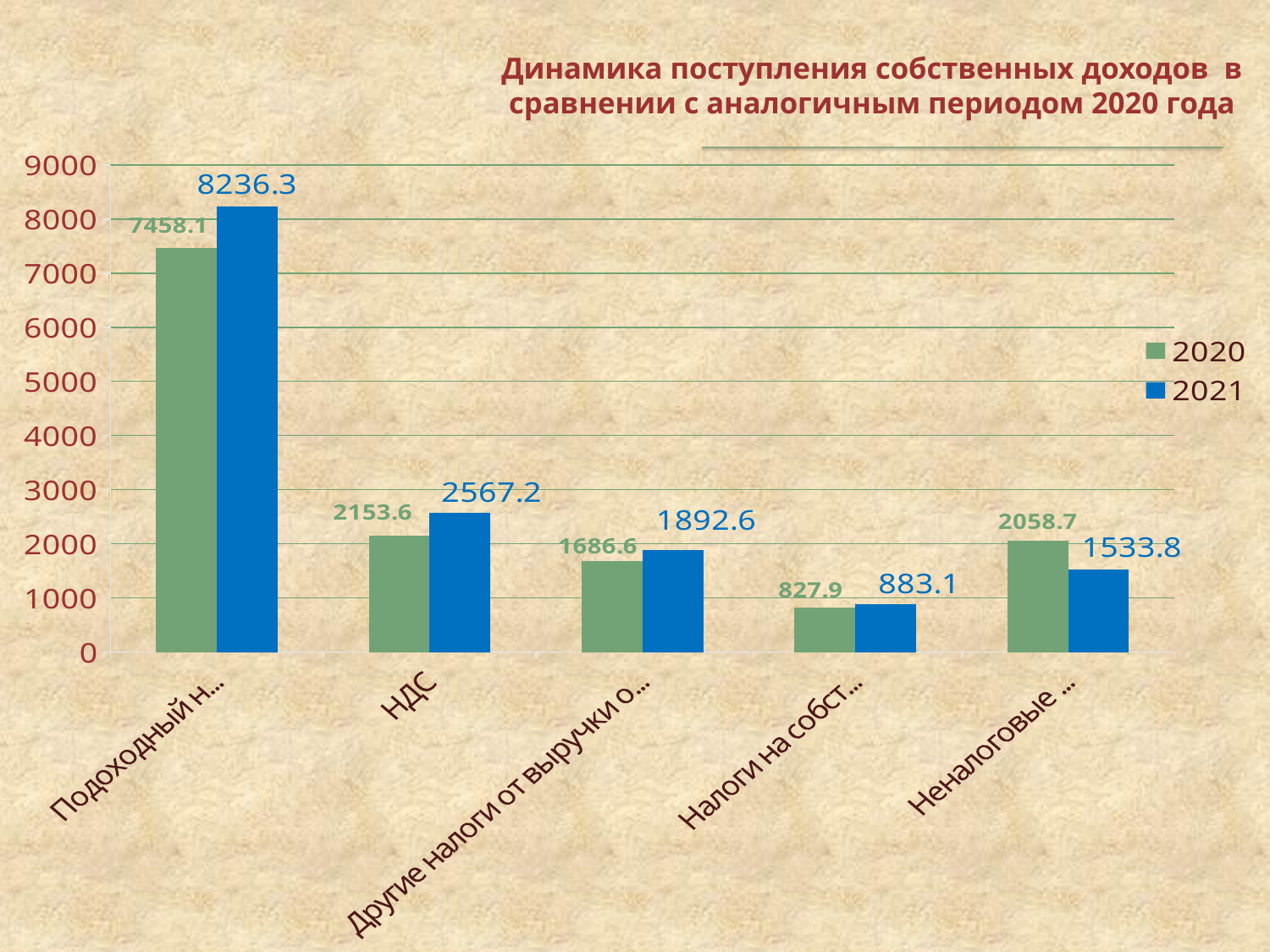
How many series does the legend list? 2 What kind of chart is shown on the slide? Bar chart What is the 2020 value for НДС? 2153.6 Which category has the lowest 2020 value? Налоги на собст... (the fourth category) What is the 2020 value for the last category (Неналоговые ...)? 2058.7 How many categories are shown on the x axis? 5 What is the 2021 value for the fourth category (Налоги на собст...)? 883.1 What is the 2021 value for НДС? 2567.2 By how much does the 2021 value for НДС exceed the 2020 value? 413.6 Which category has the highest 2021 value? Подоходный н... (the first category) What is the difference between the 2021 and 2020 values for the first category (Подоходный н...)? 778.2 For the last category (Неналоговые ...), which is larger: the 2020 value or the 2021 value? 2020